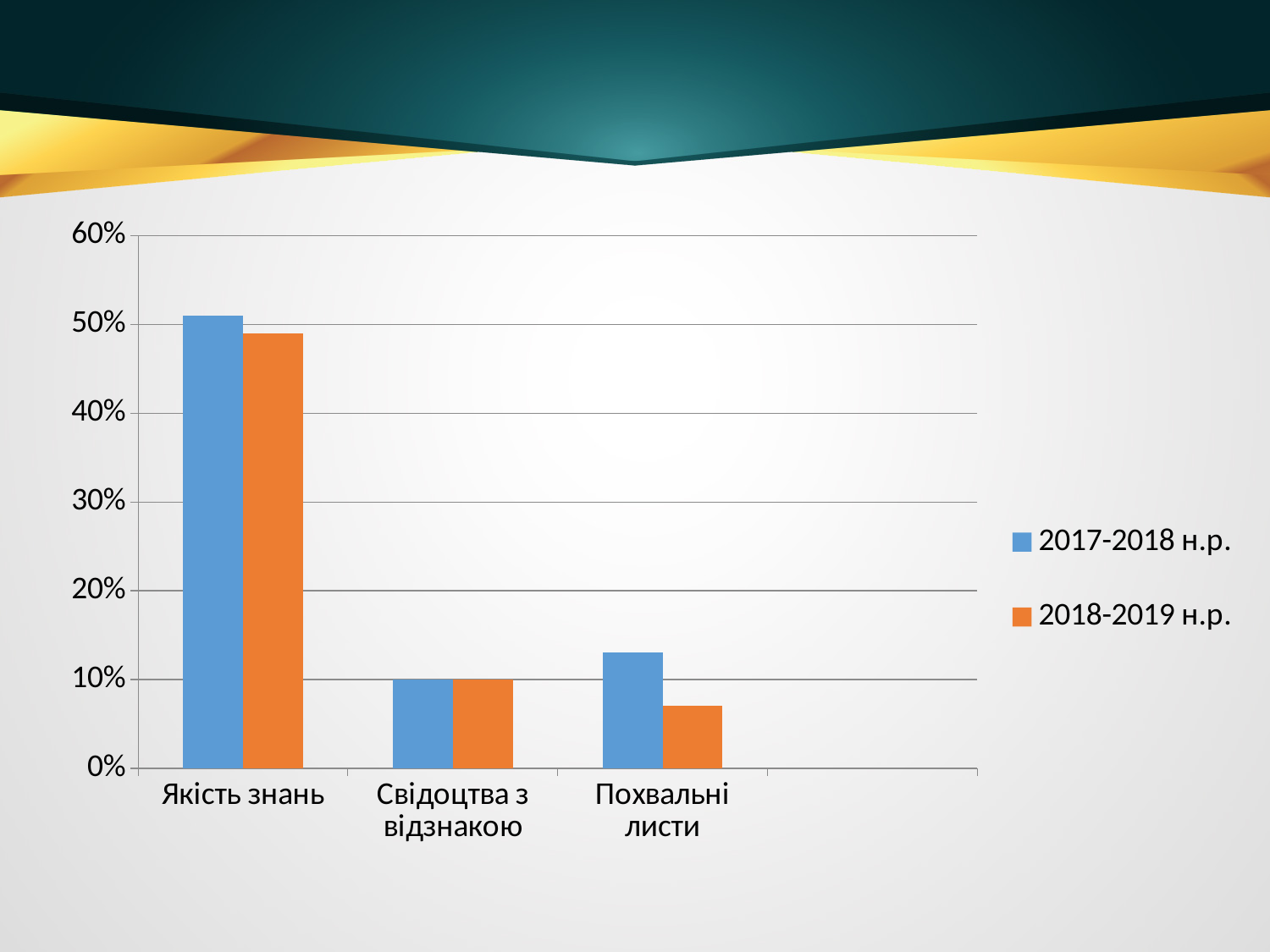
Which category has the lowest value for the 2018-2019 н.р. series? Похвальні листи Which series is shown in orange in the chart? 2018-2019 н.р. How many categories are shown on the x axis of the chart? 3 What is the value for Свідоцтва з відзнакою in the 2018-2019 н.р. series? 10% For Похвальні листи, which series has the larger value, 2017-2018 н.р. or 2018-2019 н.р.? 2017-2018 н.р. What kind of chart is shown on the slide? bar chart Is the value for Похвальні листи in 2018-2019 н.р. greater or less than 10%? less Is the value for Якість знань in 2017-2018 н.р. greater or less than 40%? greater How many series does the chart's legend list? 2 Which series is shown in blue in the chart? 2017-2018 н.р. Which category has the highest value for the 2017-2018 н.р. series? Якість знань Is the value for Похвальні листи in 2017-2018 н.р. greater or less than 10%? greater